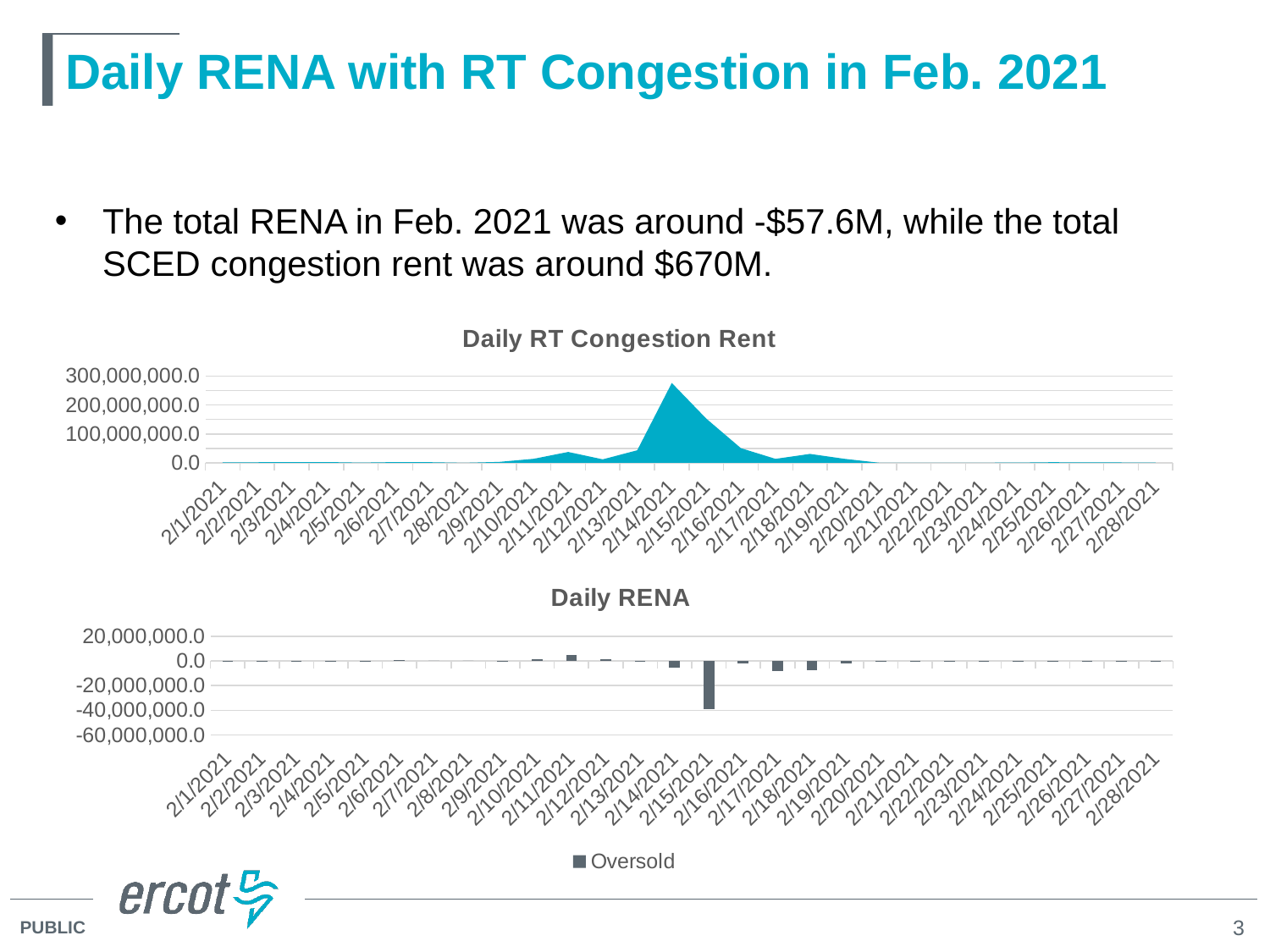
What kind of chart is the Daily RT Congestion Rent chart? area chart In the Daily RT Congestion Rent chart, is the value for 2/11/2021 greater or less than 100,000,000.0? less In the Daily RT Congestion Rent chart, is the value for 2/15/2021 greater or less than 200,000,000.0? less In the Daily RT Congestion Rent chart, which date has the highest value? 2/14/2021 How many series does the legend of the Daily RENA chart list? 1 How many dates are plotted on the x axis of the Daily RT Congestion Rent chart? 28 What kind of chart is the Daily RENA chart? bar chart What is the legend entry shown below the Daily RENA chart? Oversold In the Daily RENA chart, is the value for 2/12/2021 greater or less than 0.0? greater In the Daily RENA chart, which date has the lowest value? 2/15/2021 In the Daily RT Congestion Rent chart, which is larger, the value for 2/15/2021 or the value for 2/16/2021? 2/15/2021